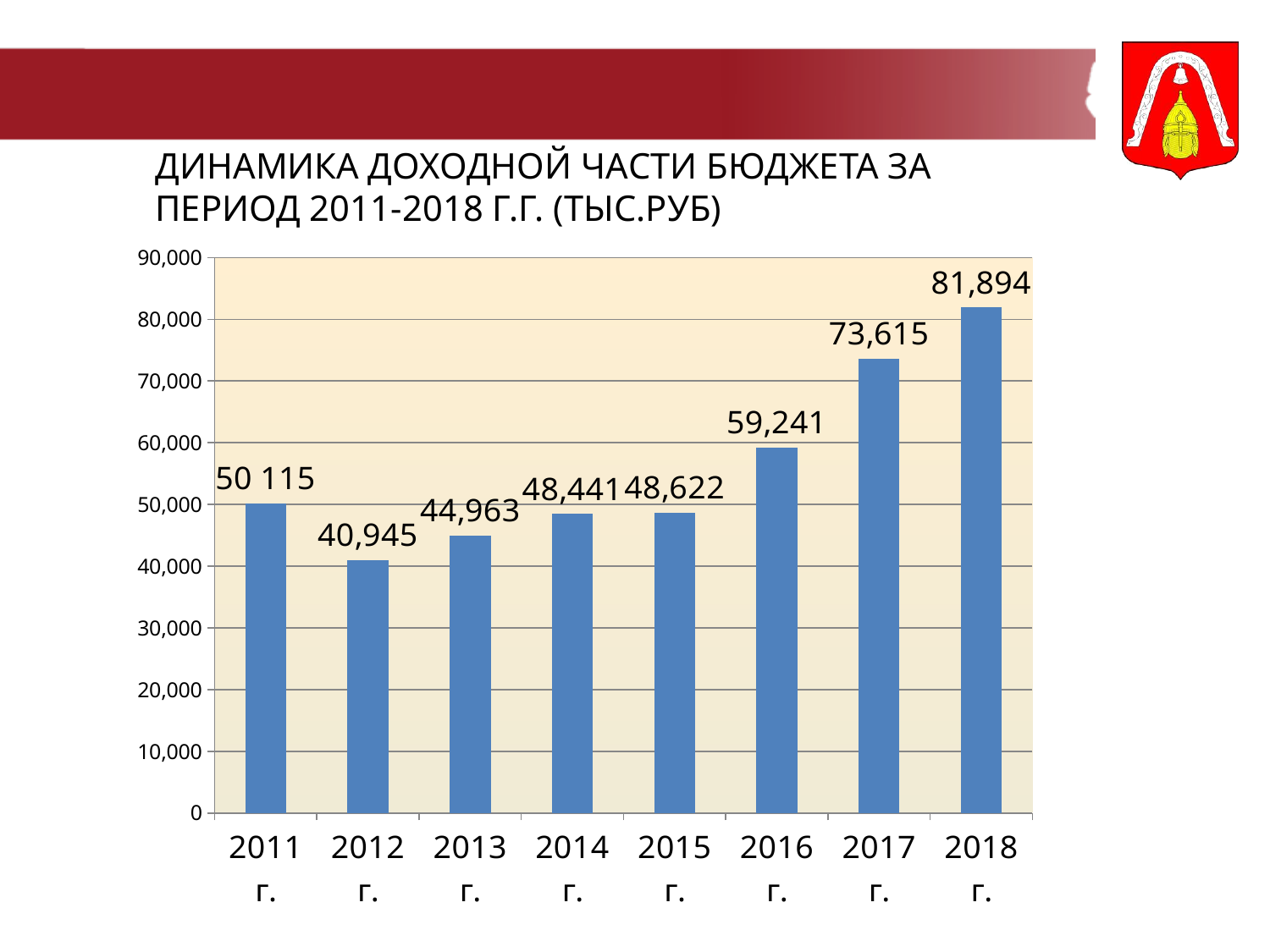
Which year has the lowest value? 2012 Is the value for 2013 greater or less than 50,000? less What is the value shown for 2016? 59,241 What is the value shown for 2013? 44,963 What is the difference between the values for 2016 and 2015? 10,619 Which is larger, the value for 2011 or the value for 2012? 2011 What kind of chart is shown on the slide? bar chart Which year has the highest value? 2018 Do the values rise or fall from 2015 to 2018? rise What is the budget revenue value for 2011? 50 115 What is the difference between the values for 2018 and 2017? 8,279 How many years are shown on the x axis? 8